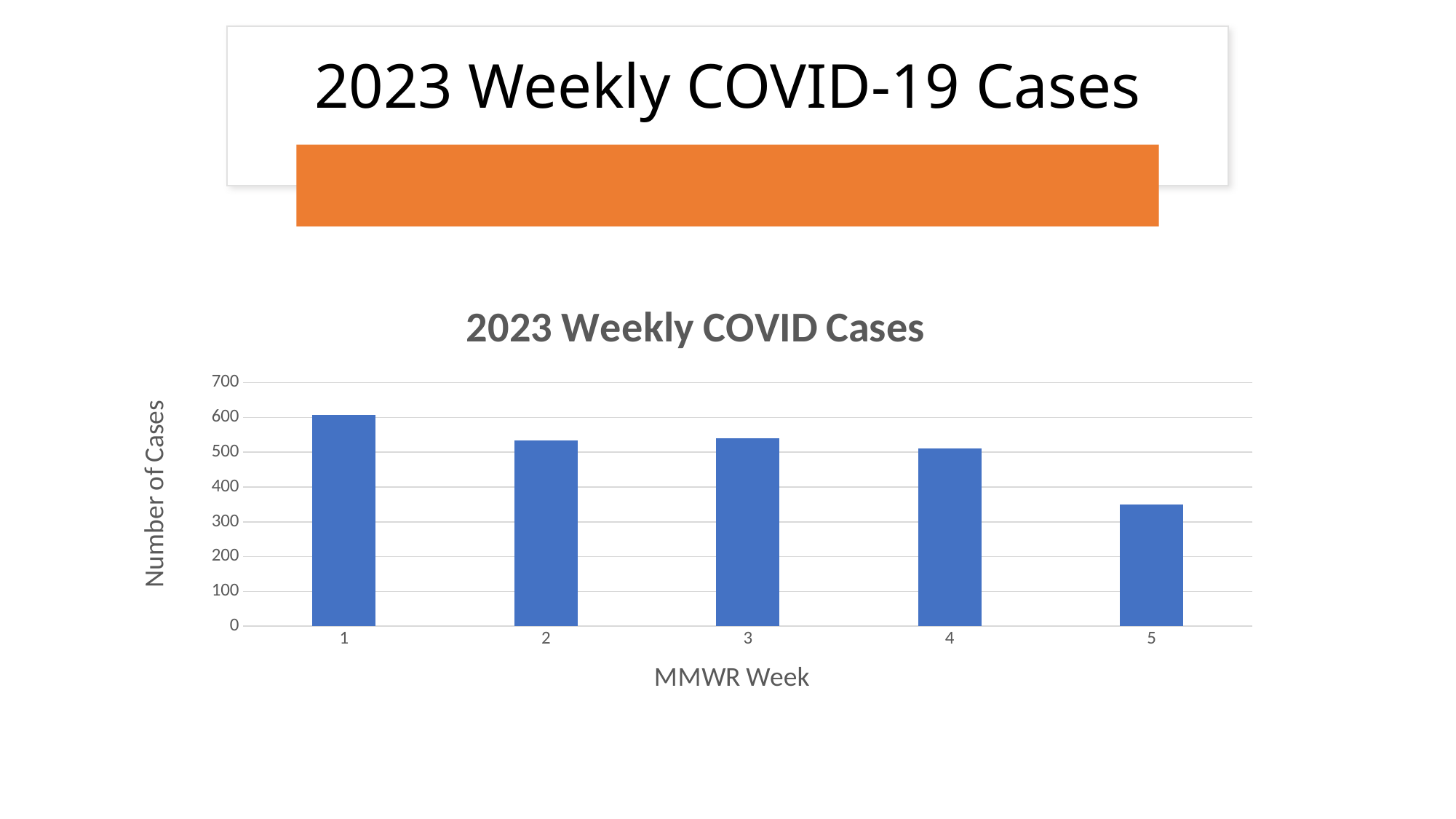
Which has more cases, MMWR week 4 or MMWR week 5? MMWR week 4 What is the title of the chart? 2023 Weekly COVID Cases Which MMWR week has the highest number of cases? 1 Is the number of cases for MMWR week 2 greater or less than 500? greater Is the number of cases for MMWR week 5 greater or less than 400? less Is the number of cases for MMWR week 1 greater or less than 500? greater Which has more cases, MMWR week 1 or MMWR week 5? MMWR week 1 What kind of chart is shown on the slide? bar chart Do the number of cases generally rise or fall from MMWR week 1 to week 5? fall Which MMWR week has the lowest number of cases? 5 How many MMWR weeks are plotted in the chart? 5